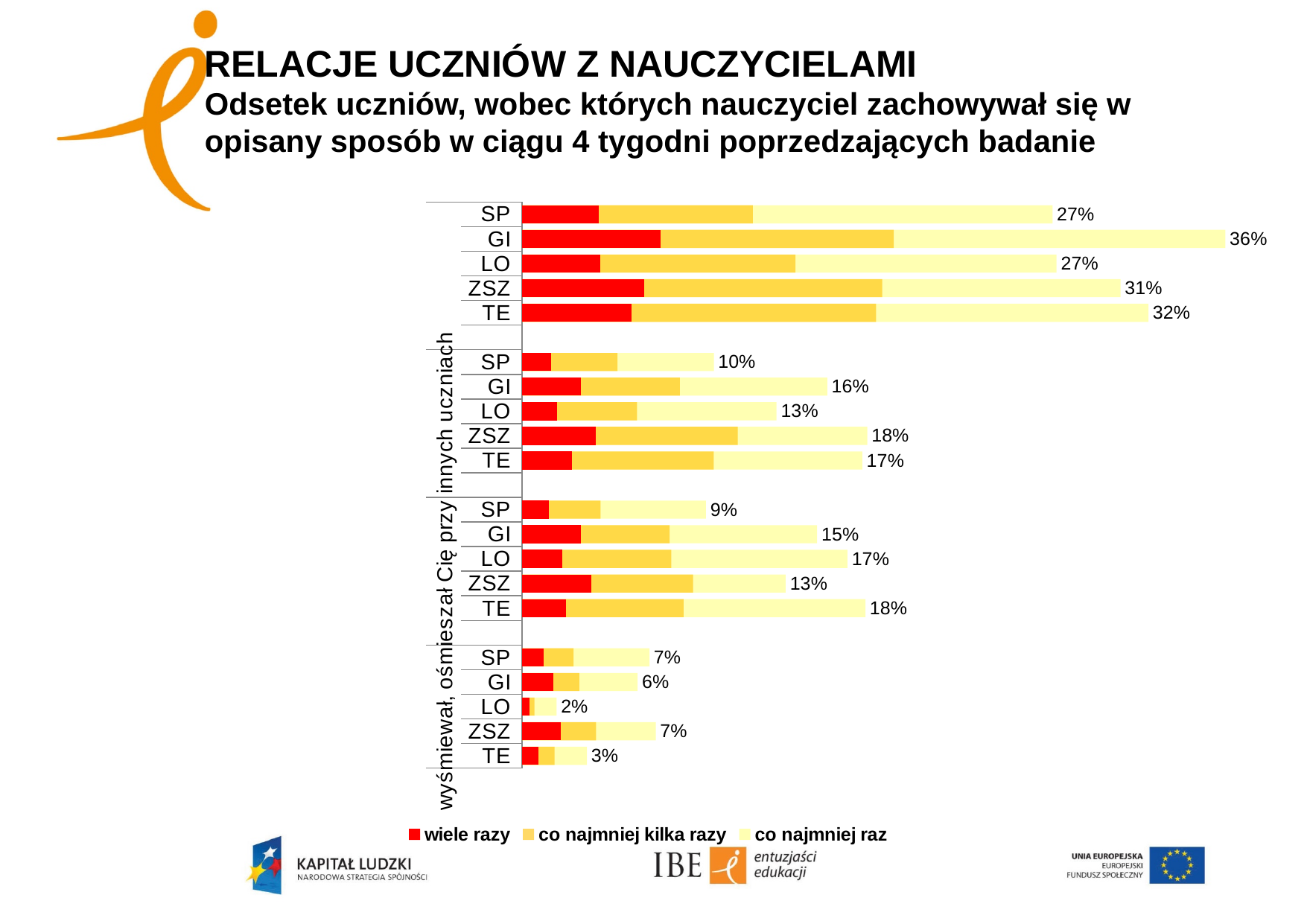
In the top group of bars, which school type has the highest value? GI In the top group of bars, what is the difference between the values for GI and SP? 9% What are the three legend entries? wiele razy, co najmniej kilka razy, co najmniej raz What type of chart is shown on the slide? stacked bar chart In the second group of bars from the top, what value is shown for LO? 13% In the third group of bars from the top, what value is shown for TE? 18% How many series does the legend list? 3 How many school types are listed in each group of bars? 5 In the second group of bars from the top, which is larger, the value for ZSZ or the value for SP? ZSZ In the top group of bars, what value is shown for GI? 36%